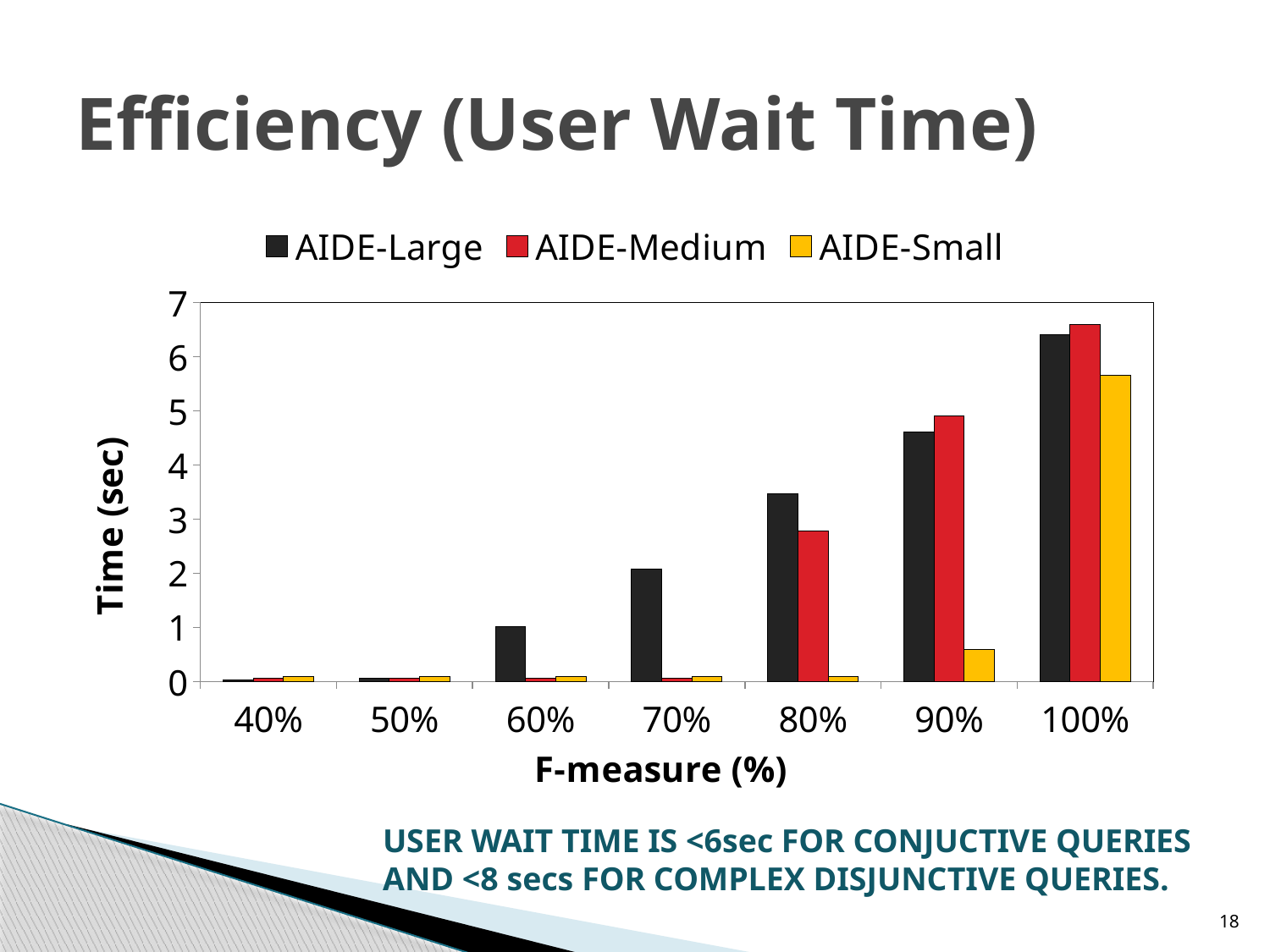
How many F-measure categories are shown on the x axis? 7 At 80% F-measure, which is larger: AIDE-Large or AIDE-Medium? AIDE-Large What kind of chart is shown on the slide? bar chart How many series does the legend list? 3 At 90% F-measure, which is larger: AIDE-Medium or AIDE-Large? AIDE-Medium At which F-measure is the AIDE-Large time highest? 100% Is the AIDE-Large value at 80% F-measure greater or less than 3? greater Is the AIDE-Medium value at 80% F-measure greater or less than 3? less Is the AIDE-Large value at 100% F-measure greater or less than 6? greater Which series has the lowest time at 90% F-measure? AIDE-Small Do the AIDE-Large values rise or fall as F-measure increases from 40% to 100%? rise